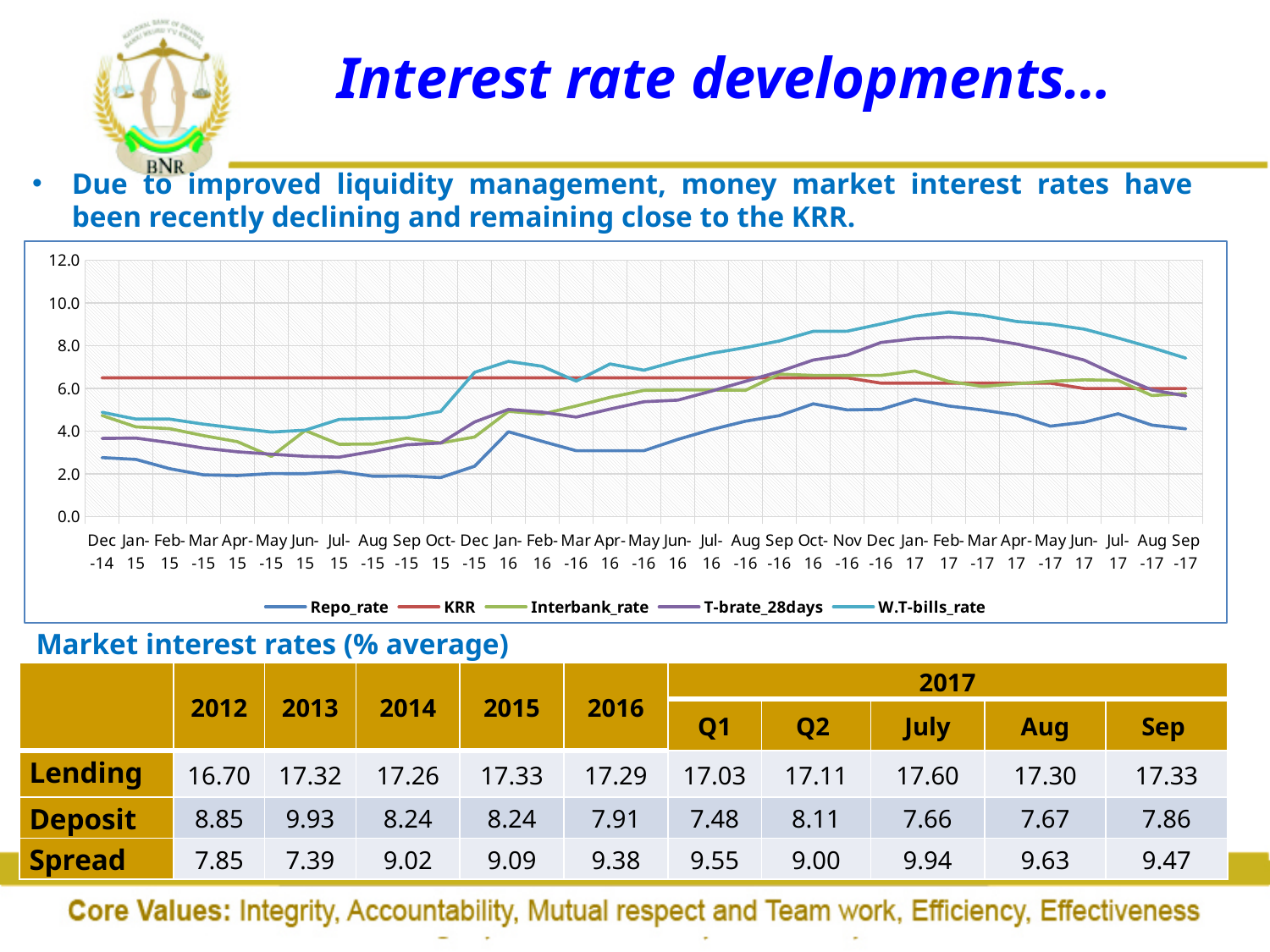
Which series has the highest value in Sep-17? W.T-bills_rate Does the W.T-bills_rate rise or fall between Feb-17 and Sep-17? fall Is the value of W.T-bills_rate in Feb-17 greater or less than 8.0? greater Is the value of W.T-bills_rate in Sep-17 greater or less than 8.0? less How many series does the chart's legend list? 5 Is the value of Repo_rate in Dec-14 greater or less than 4.0? less Which series reaches the highest value anywhere on the chart? W.T-bills_rate Which series has the lowest value in Dec-14? Repo_rate What kind of chart is shown on the slide? line chart What colour is the KRR line in the chart? red